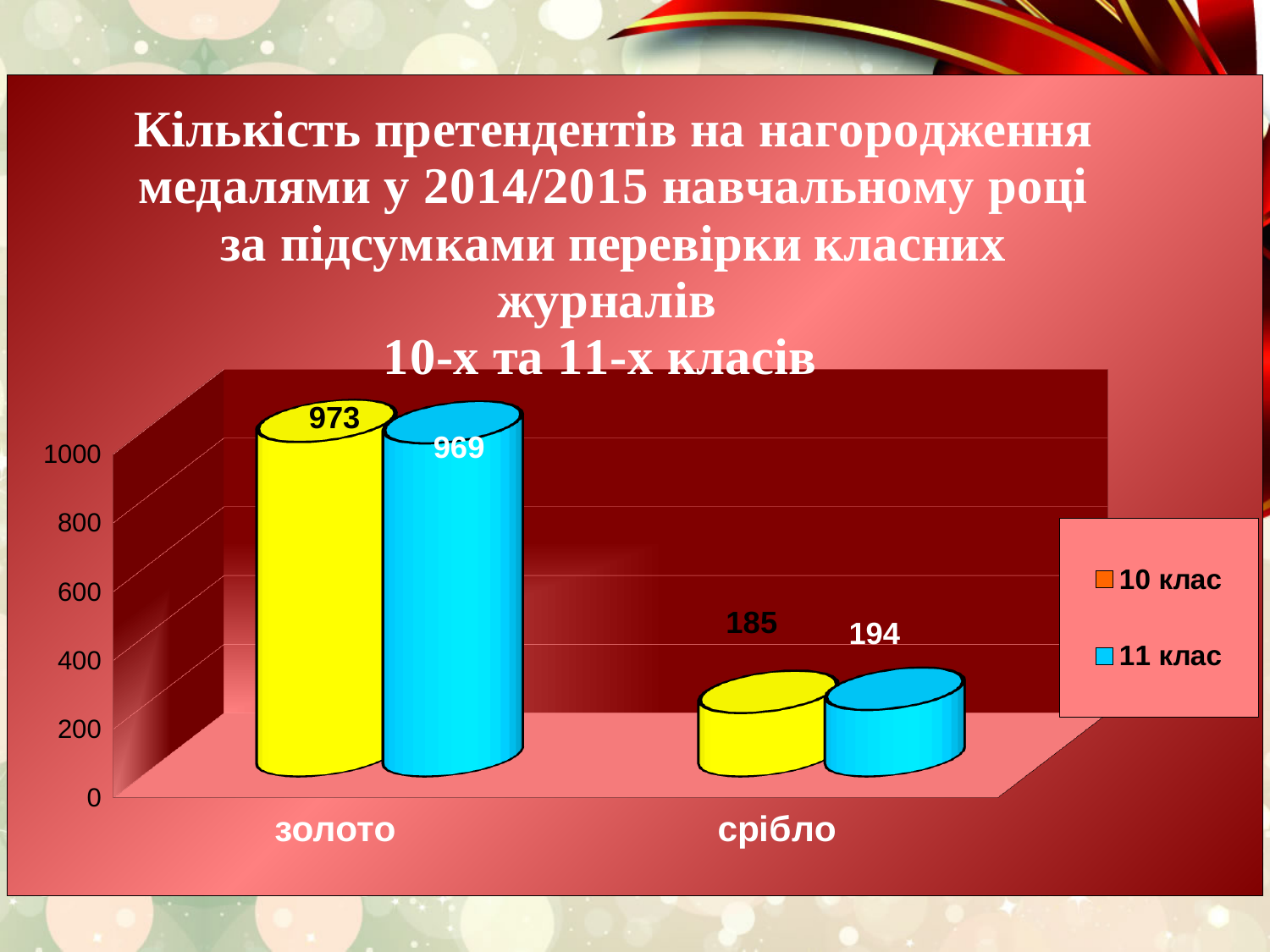
What is the value for 10 клас in the золото category? 973 Which category has the lowest value for 11 клас? срібло What is the value for 11 клас in the золото category? 969 Is the value for 10 клас in золото greater or less than 800? greater What is the difference between the 11 клас and 10 клас values in the срібло category? 9 Which category has the highest value for 10 клас? золото What is the value for 11 клас in the срібло category? 194 How many series does the legend list? 2 What kind of chart is shown on the slide? bar chart What is the value for 10 клас in the срібло category? 185 What is the difference between the 10 клас and 11 клас values in the золото category? 4 How many categories are shown on the x axis? 2